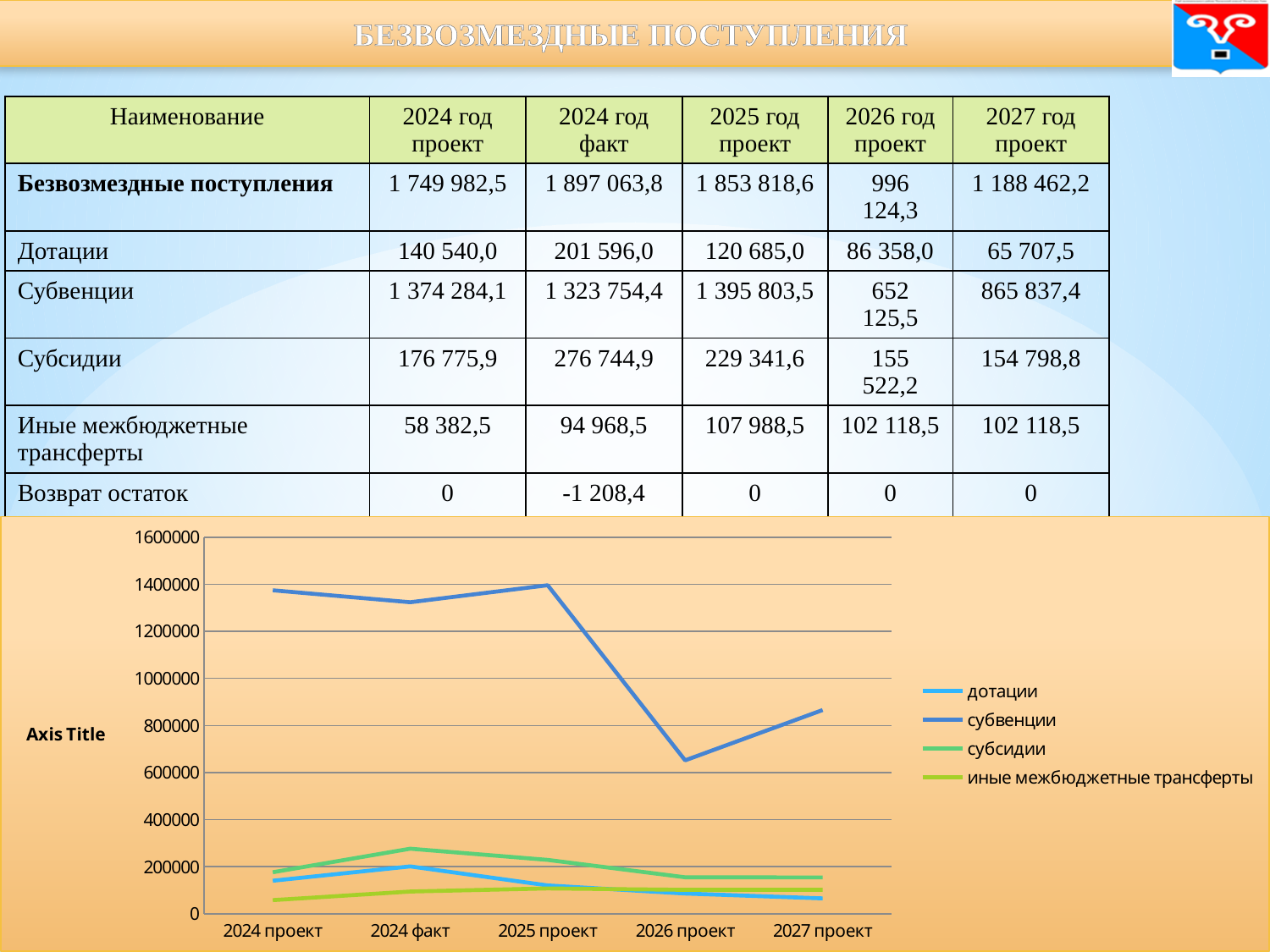
In the chart, at which category is the субвенции line lowest? 2026 проект Is the value of субсидии for 2024 факт greater or less than 200000? greater In the chart, at which category is the субсидии line highest? 2024 факт What is the title shown on the vertical axis of the chart? Axis Title How many series does the chart legend list? 4 Is the value of субвенции for 2026 проект greater or less than 800000? less Does the субвенции line rise or fall from 2025 проект to 2026 проект? fall In the chart, at which category is the иные межбюджетные трансферты line lowest? 2024 проект How many categories are shown along the x axis of the chart? 5 Is the value of субвенции for 2027 проект greater or less than 800000? greater What kind of chart is shown at the bottom of the slide? line chart At 2025 проект, which series has the larger value: субвенции or субсидии? субвенции